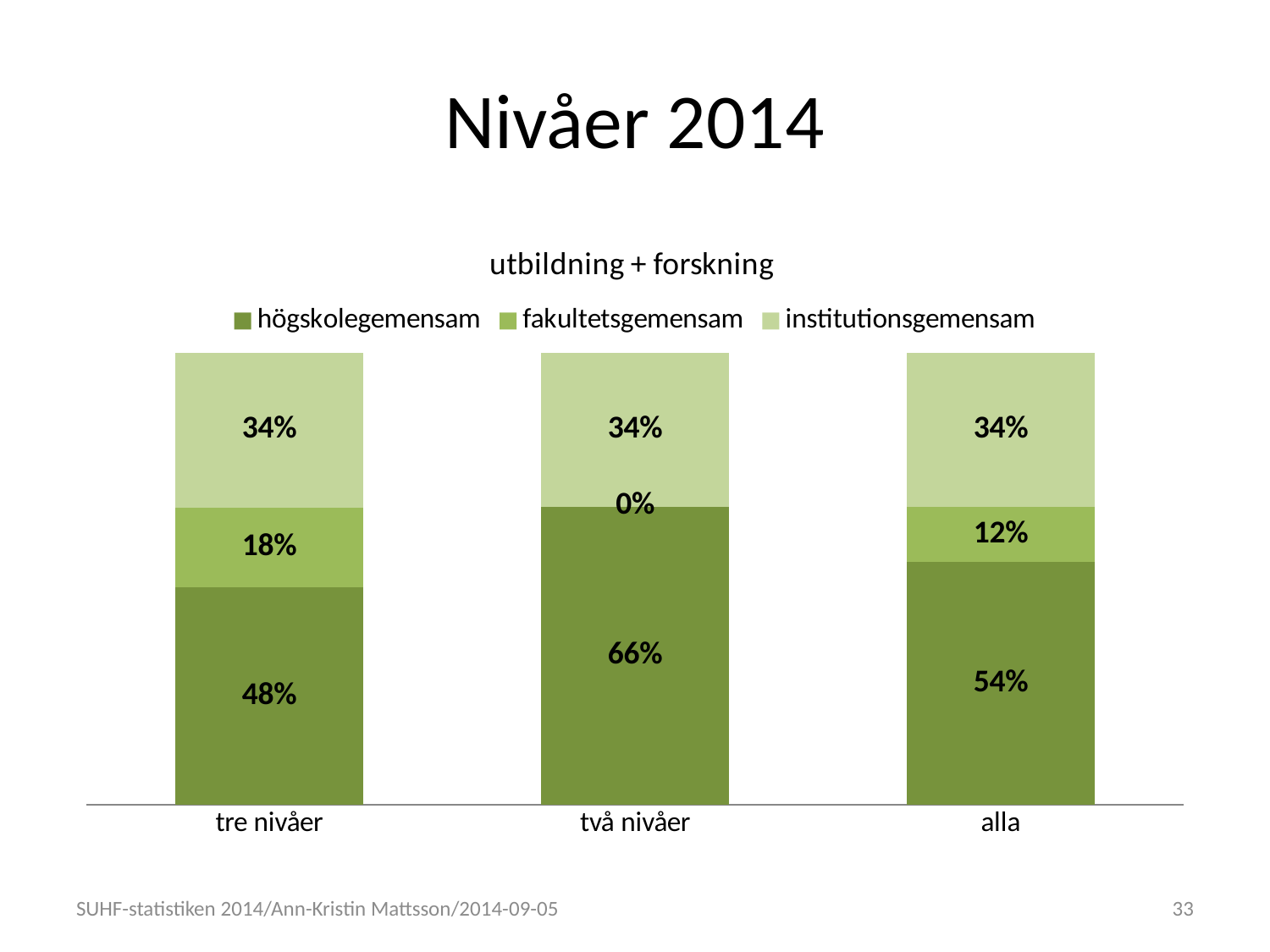
What kind of chart is shown? stacked bar chart What is the title of the chart? utbildning + forskning How many series does the legend list? 3 Which is larger: the fakultetsgemensam value for tre nivåer or for alla? tre nivåer What is the difference between the högskolegemensam values for två nivåer and tre nivåer? 18% What is the value of institutionsgemensam for två nivåer? 34% What is the value of högskolegemensam for tre nivåer? 48% What is the value of fakultetsgemensam for alla? 12% What is the value of fakultetsgemensam for två nivåer? 0% Which category has the lowest fakultetsgemensam value? två nivåer How many categories are shown on the x axis? 3 Which category has the highest högskolegemensam value? två nivåer